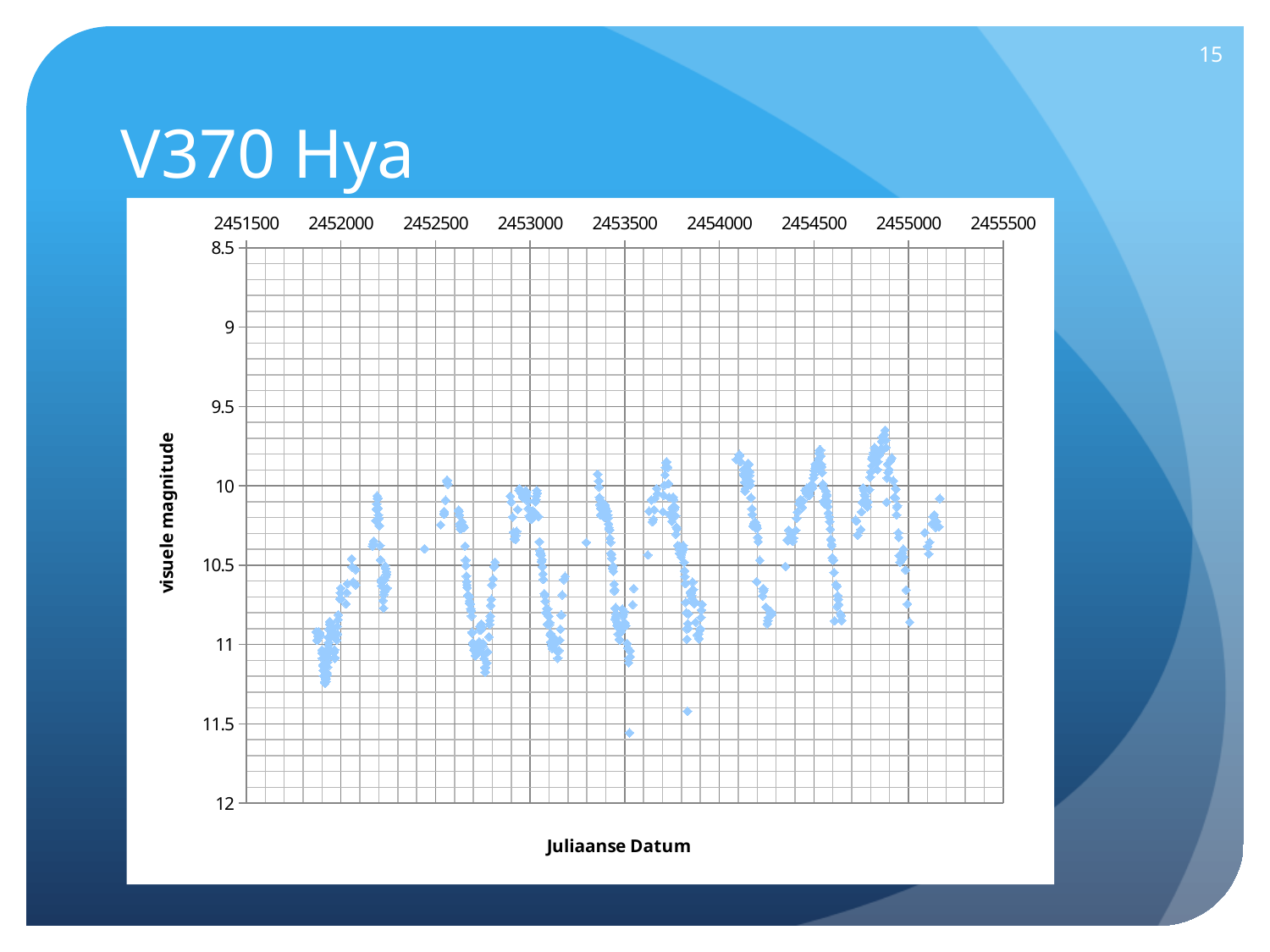
What is the bottommost tick label on the y axis? 12 What is the title of the y axis of the chart? visuele magnitude Are any data points plotted beyond Julian date 2455500 on the x axis? No What is the first tick label on the x axis? 2451500 How many tick labels are shown on the x axis? 9 What is the topmost tick label on the y axis? 8.5 What is the last tick label on the x axis? 2455500 What kind of chart is shown on the slide? scatter chart Are the points plotted near Julian date 2452000 greater or less than magnitude 10? greater Is the smallest magnitude value plotted (the highest point on the chart) greater or less than 9.5? greater What is the title of the x axis of the chart? Juliaanse Datum